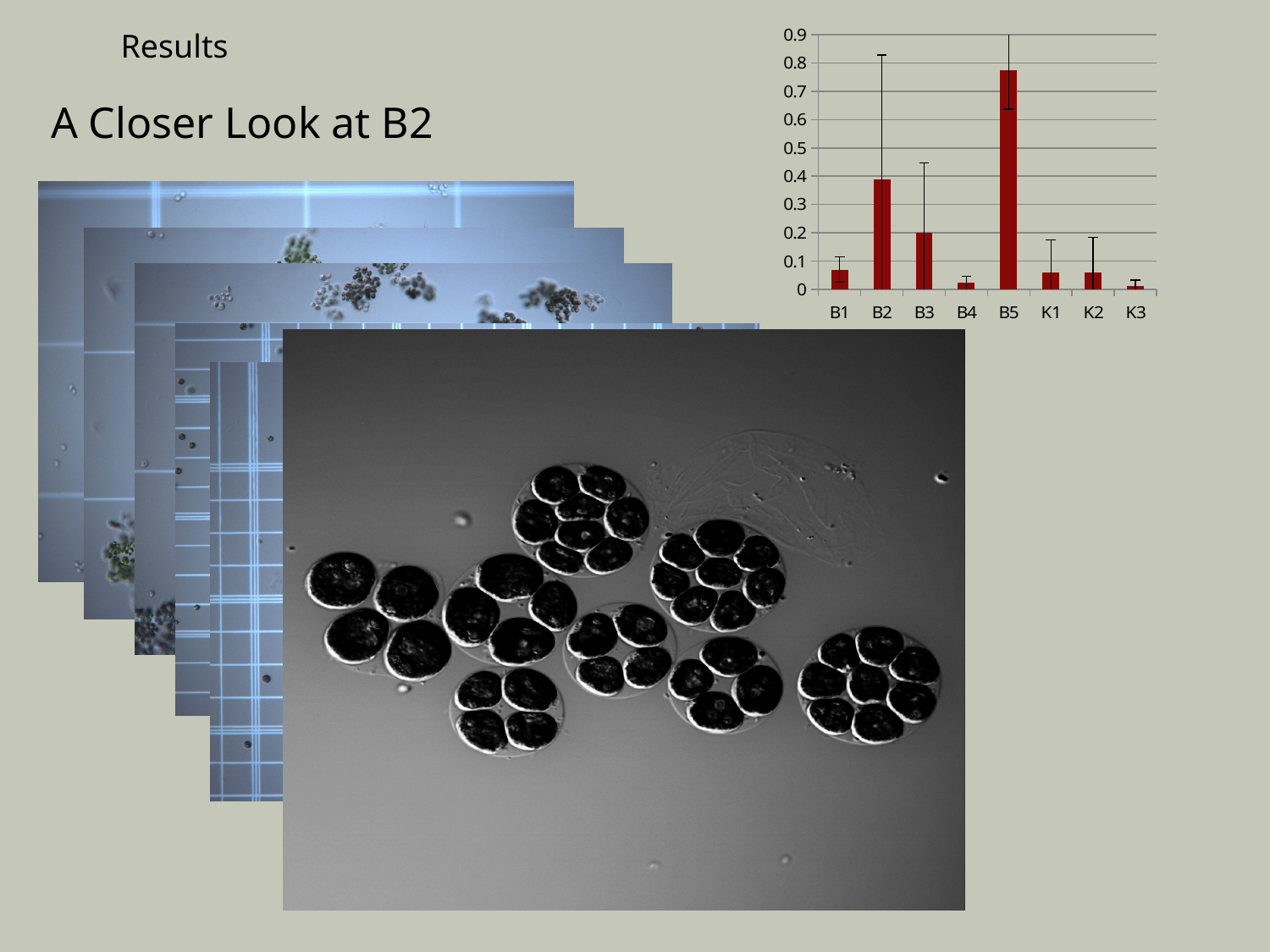
Is the value for B2 greater or less than 0.3? greater How many categories are shown on the x axis of the chart? 8 What colour are the bars in the chart? red Which is larger in the chart, the value for B1 or the value for B4? B1 What kind of chart is shown on the slide? bar chart Is the value for K1 greater or less than 0.1? less Which category has the highest value in the chart? B5 Is the value for B5 greater or less than 0.7? greater Which is larger in the chart, the value for B5 or the value for B2? B5 Which is larger in the chart, the value for B2 or the value for B3? B2 What is the highest value labelled on the y axis of the chart? 0.9